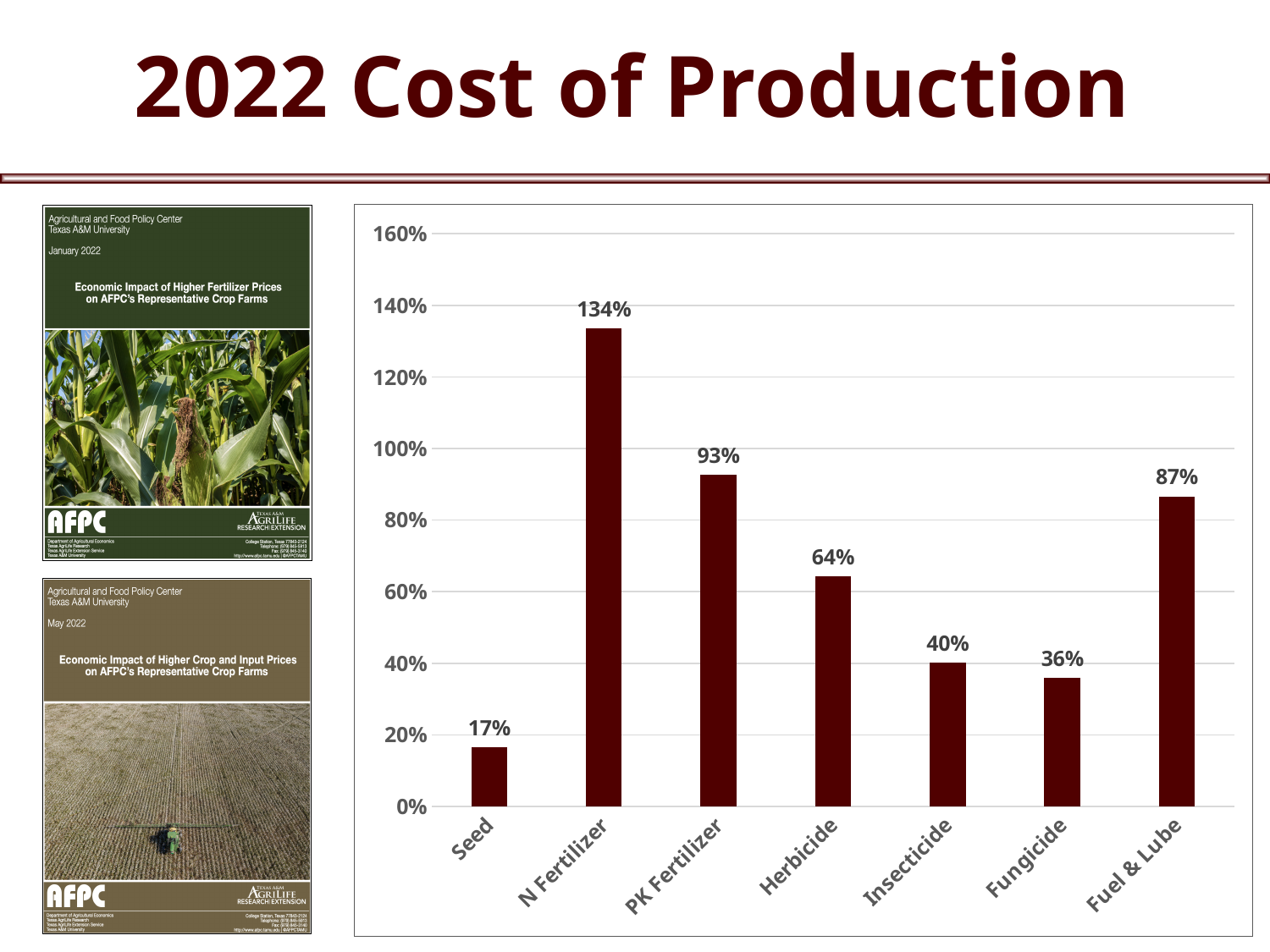
What is the difference between the values for N Fertilizer and PK Fertilizer? 41% Is the value for PK Fertilizer greater or less than 100%? less Which is larger, the value for Herbicide or the value for Fuel & Lube? Fuel & Lube What kind of chart is shown on the slide? bar chart How many categories are shown on the x axis? 7 What is the value for Herbicide? 64% What is the value for N Fertilizer? 134% Which category has the lowest value? Seed Which category has the highest value? N Fertilizer What is the difference between the values for Insecticide and Fungicide? 4% What is the title of the slide? 2022 Cost of Production What is the value for Fuel & Lube? 87%